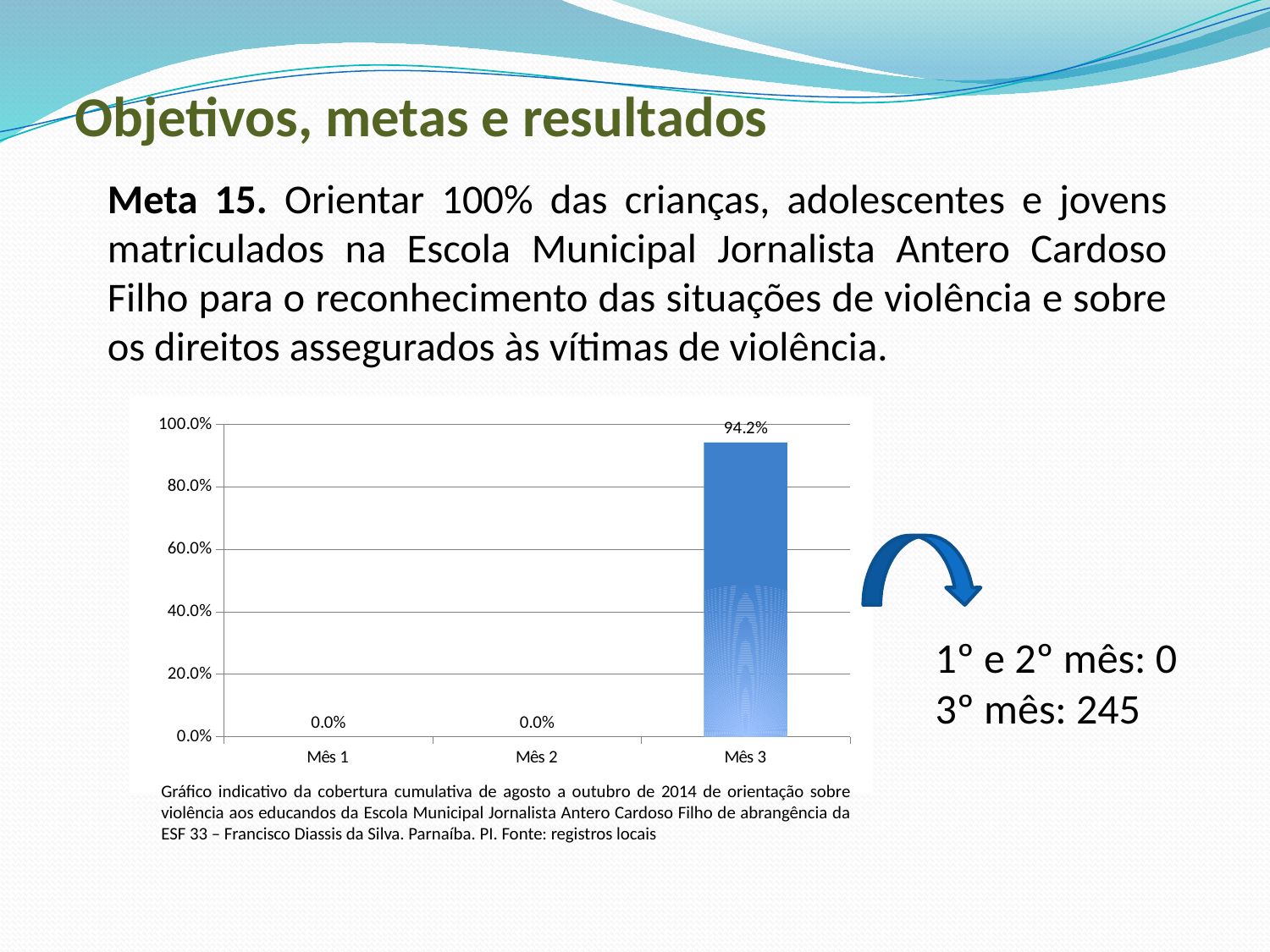
What is the value for Mês 1? 0.0% What is the difference between the values for Mês 3 and Mês 2? 94.2% Is the value for Mês 3 greater or less than 80.0%? greater What is the value for Mês 3? 94.2% What kind of chart is shown? bar chart Which month has the highest value? Mês 3 Which is larger, the value for Mês 3 or the value for Mês 1? Mês 3 What is the value for Mês 2? 0.0% How many months are shown on the x axis? 3 Do the values rise or fall from Mês 1 to Mês 3? rise What colour is the bar for Mês 3? blue What is the highest value shown on the y axis? 100.0%